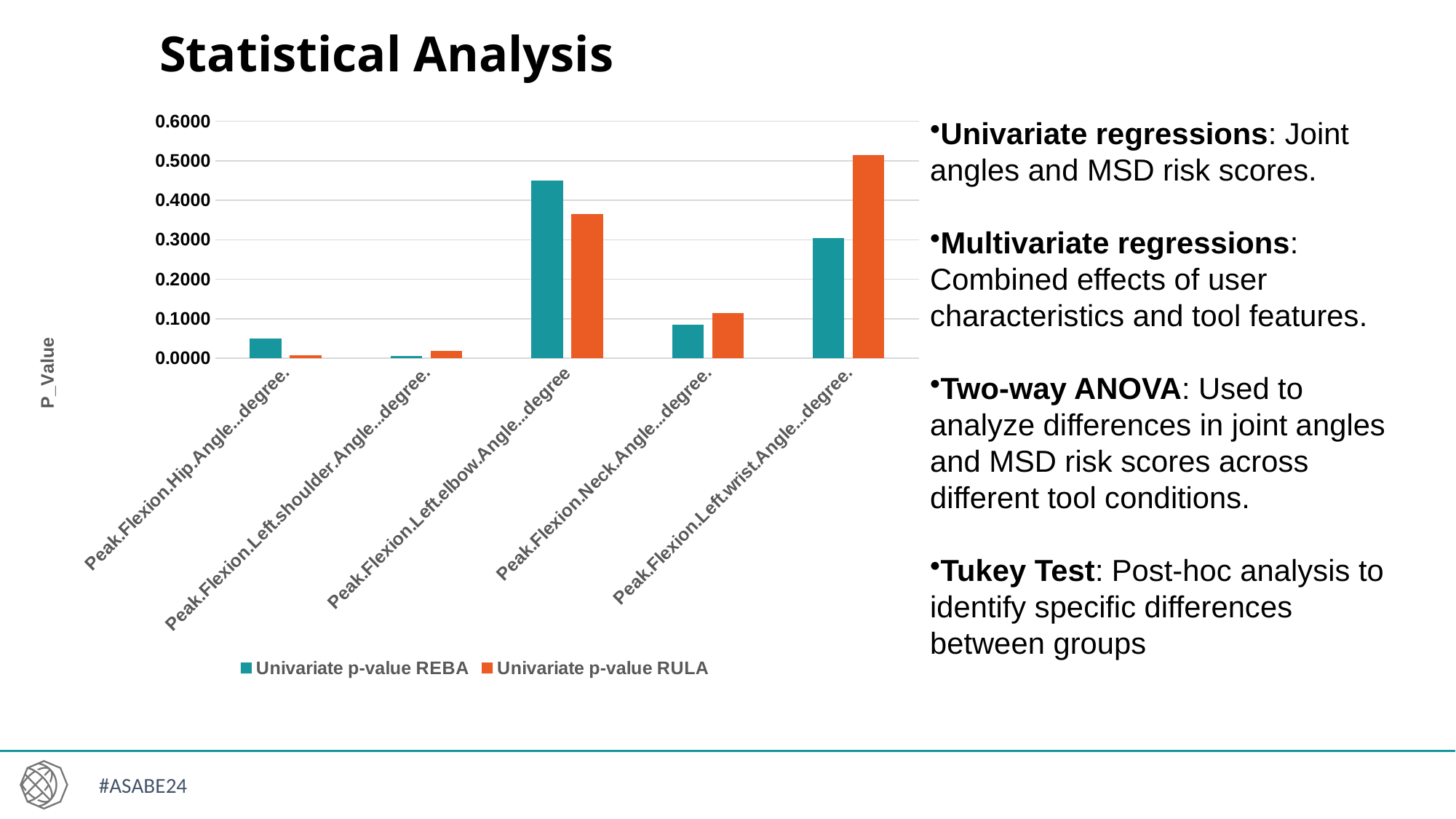
Which category has the lowest Univariate p-value RULA? Peak.Flexion.Hip.Angle...degree. How many categories are shown on the x axis? 5 Which category has the highest Univariate p-value RULA? Peak.Flexion.Left.wrist.Angle...degree. Is the Univariate p-value REBA for Peak.Flexion.Left.elbow.Angle...degree greater or less than 0.4000? greater Is the Univariate p-value REBA for Peak.Flexion.Neck.Angle...degree. greater or less than 0.1000? less Is the Univariate p-value RULA for Peak.Flexion.Left.wrist.Angle...degree. greater or less than 0.5000? greater For Peak.Flexion.Left.wrist.Angle...degree., which is larger: the Univariate p-value REBA or the Univariate p-value RULA? Univariate p-value RULA What kind of chart is shown on the slide? bar chart How many series does the legend list? 2 Which category has the highest Univariate p-value REBA? Peak.Flexion.Left.elbow.Angle...degree Which category has the lowest Univariate p-value REBA? Peak.Flexion.Left.shoulder.Angle...degree. What is the label on the vertical axis of the chart? P_Value